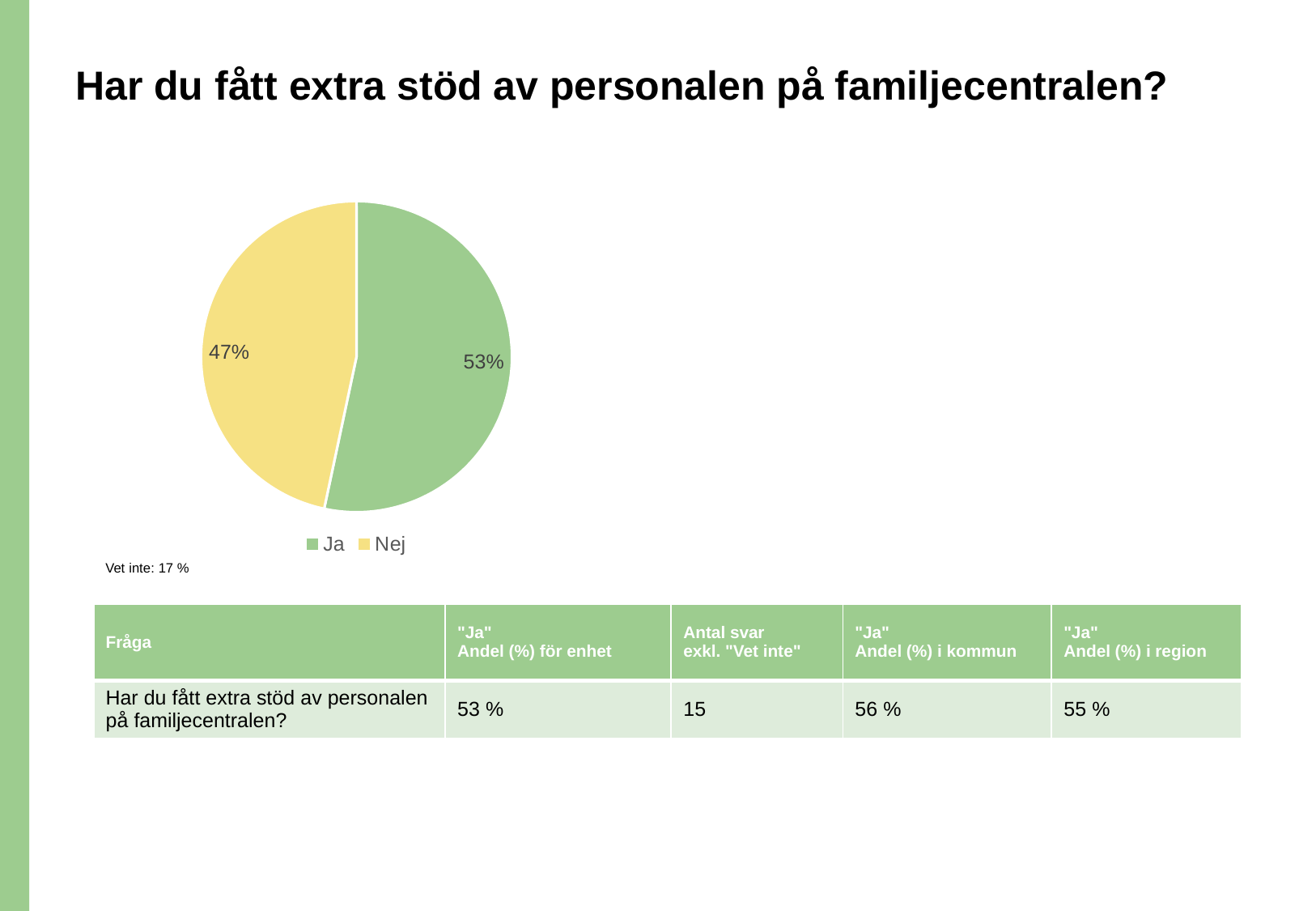
How many slices does the pie chart have? 2 What share of the pie does the "Ja" slice represent? 53% What share of the pie does the "Nej" slice represent? 47% What colour is the "Ja" slice in the pie chart? green What kind of chart is shown on the slide? pie chart What is the difference in percentage points between the "Ja" and "Nej" slices? 6 Which slice of the pie is the largest? Ja How many entries does the legend list? 2 Which is larger, the "Ja" slice or the "Nej" slice? Ja What colour is the "Nej" slice in the pie chart? yellow Which slice of the pie is the smallest? Nej Is the share of the "Ja" slice greater or less than 50%? greater